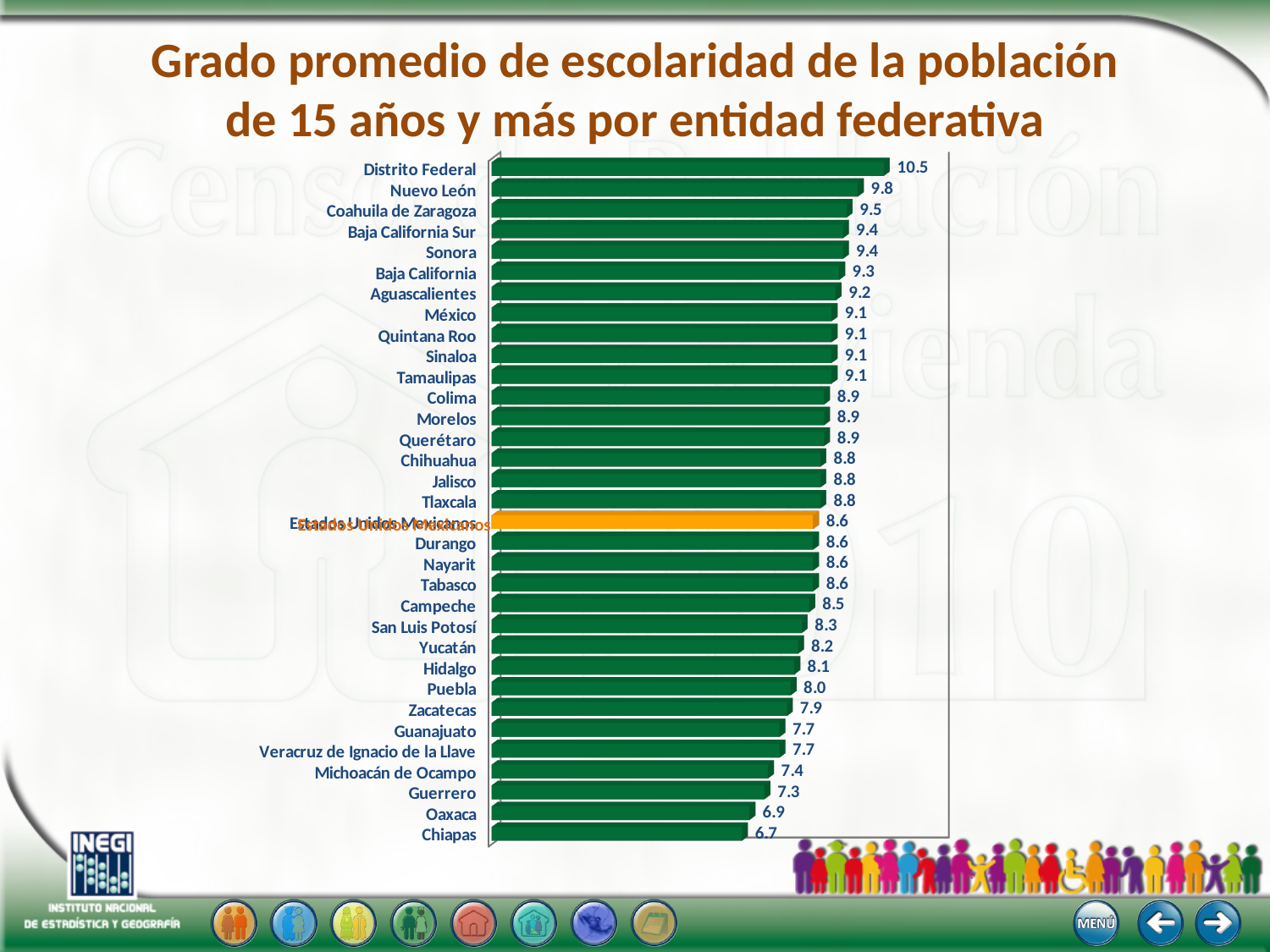
How many bars are plotted in the chart? 33 What is the difference between the values for Distrito Federal and Chiapas? 3.8 Which is larger, the value for Sonora or the value for Puebla? Sonora Which entity has the highest value? Distrito Federal What is the difference between the values for Nuevo León and Oaxaca? 2.9 What kind of chart is shown on the slide? Bar chart Which entity has the lowest value? Chiapas Which bar is highlighted in orange rather than green? Estados Unidos Mexicanos What is the value for Estados Unidos Mexicanos (the orange bar)? 8.6 What is the value for Distrito Federal? 10.5 What is the value for Guerrero? 7.3 What is the value for Chiapas? 6.7